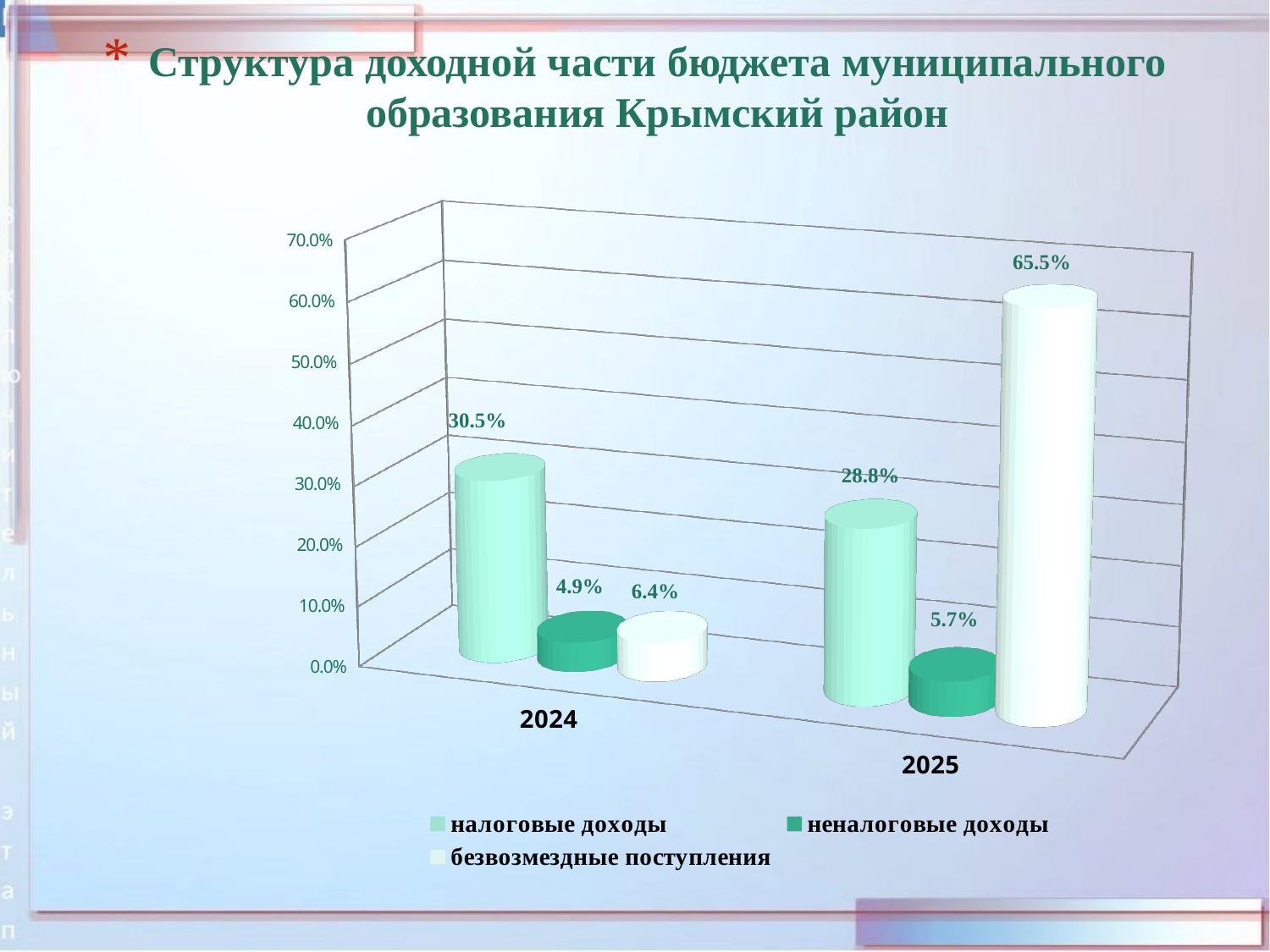
How many categories are shown on the x axis? 2 What is the value for неналоговые доходы in 2025? 5.7% What is the difference between безвозмездные поступления in 2025 and in 2024? 59.1% What is the value for налоговые доходы in 2024? 30.5% What is the value for безвозмездные поступления in 2025? 65.5% Which is larger: налоговые доходы in 2024 or налоговые доходы in 2025? налоговые доходы in 2024 What kind of chart is shown on the slide? bar chart What is the value for безвозмездные поступления in 2024? 6.4% Which series has the highest value in 2025? безвозмездные поступления Does the value for налоговые доходы rise or fall from 2024 to 2025? fall How many series does the legend list? 3 Which series has the lowest value in 2024? неналоговые доходы